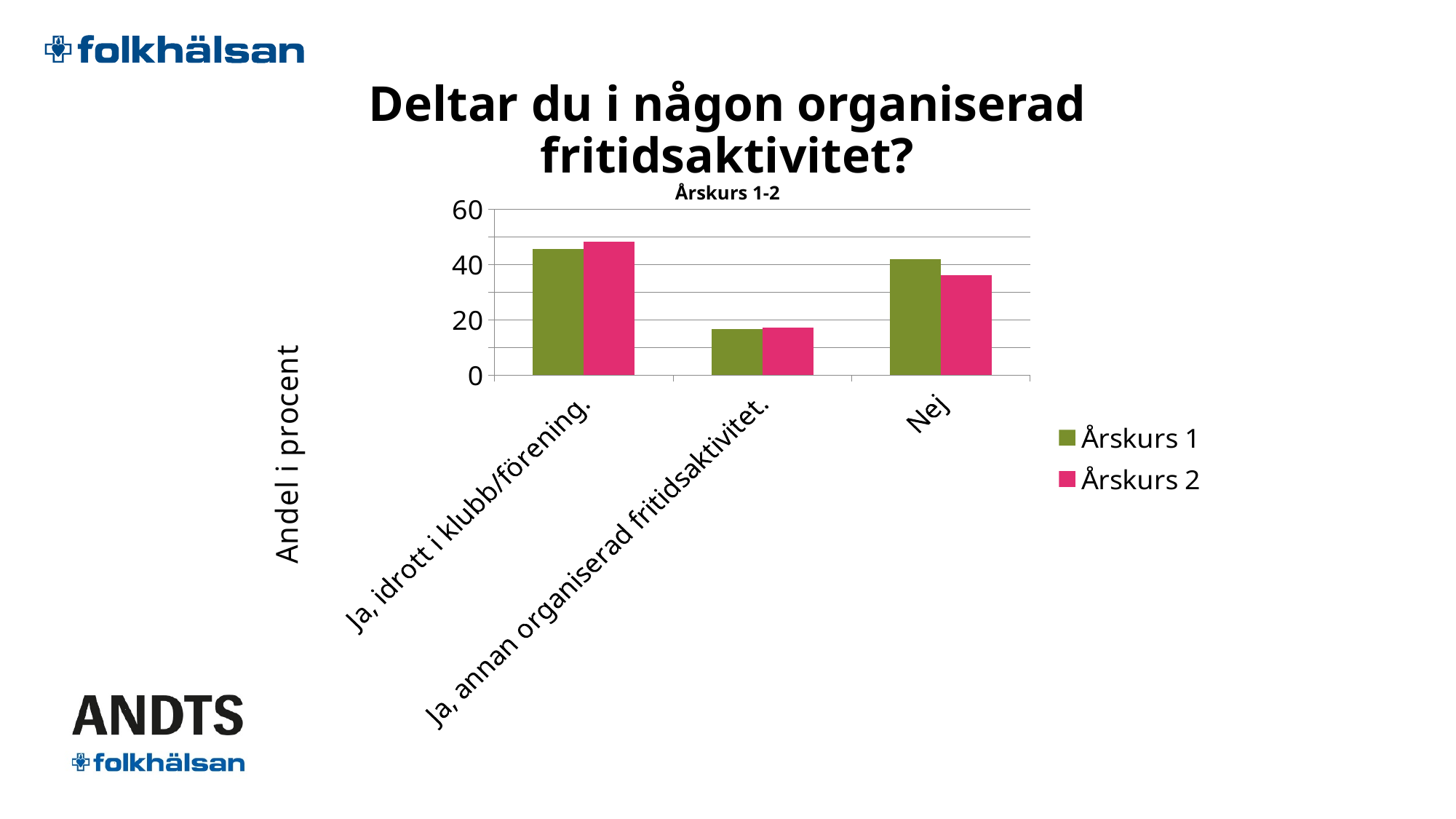
Which category has the highest value for Årskurs 2? Ja, idrott i klubb/förening. Is the value for Årskurs 1 in the category Ja, annan organiserad fritidsaktivitet. greater or less than 20? less For the category Nej, which series has the larger value, Årskurs 1 or Årskurs 2? Årskurs 1 Is the value for Årskurs 2 in the category Nej greater or less than 40? less Is the value for Årskurs 1 in the category Ja, idrott i klubb/förening. greater or less than 40? greater What is the title shown directly above the chart's plot area? Årskurs 1-2 Which category has the lowest value for Årskurs 1? Ja, annan organiserad fritidsaktivitet. How many series does the chart's legend list? 2 What kind of chart is shown on the slide? bar chart Which category has the lowest value for Årskurs 2? Ja, annan organiserad fritidsaktivitet. What is the label of the chart's vertical axis? Andel i procent How many categories are shown on the x axis of the chart? 3